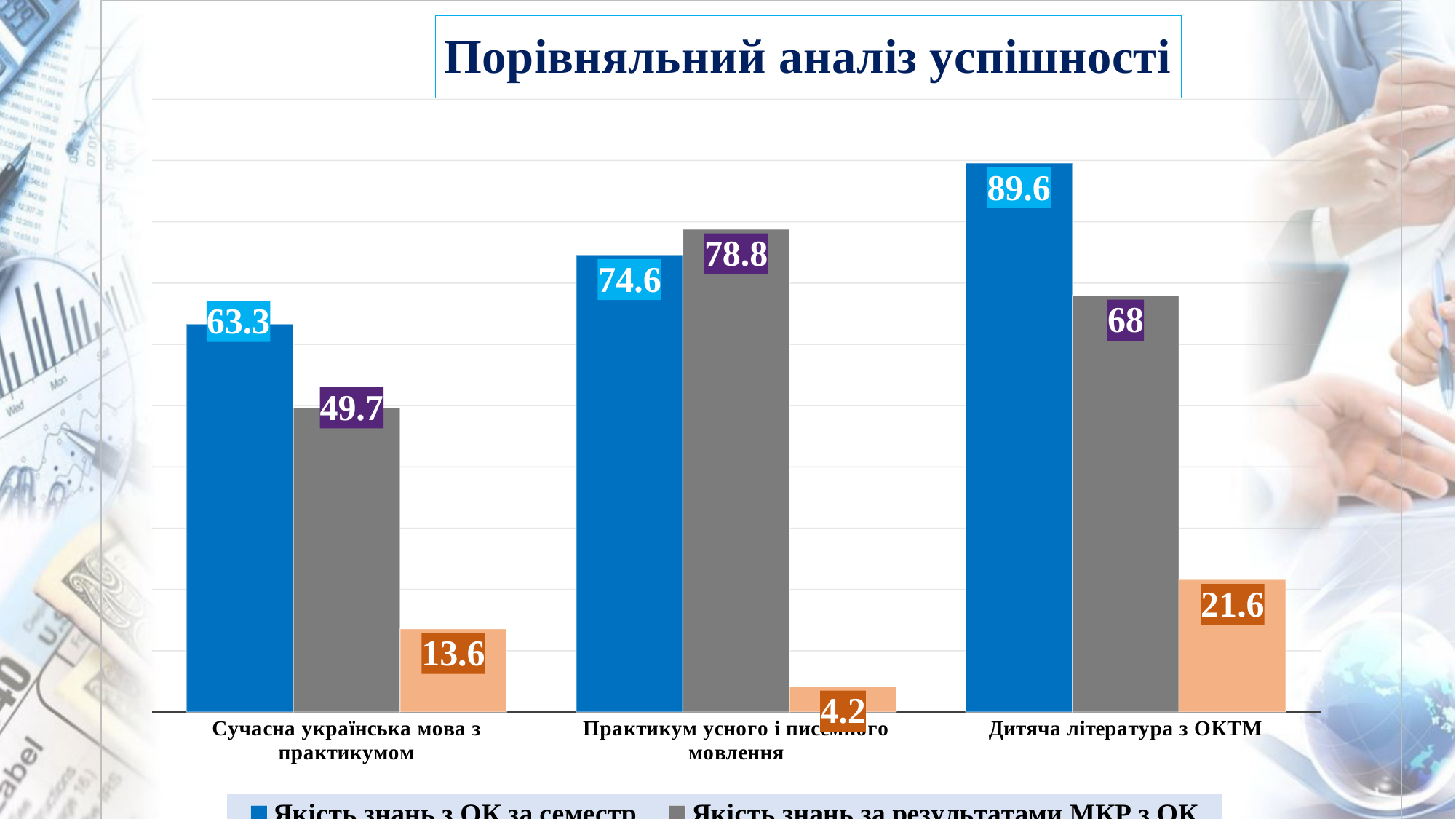
Which category has the highest value for 'Якість знань з ОК за семестр'? Дитяча література з ОКТМ What is the value of the orange bar for 'Практикум усного і писемного мовлення'? 4.2 What is the value of 'Якість знань з ОК за семестр' for 'Дитяча література з ОКТМ'? 89.6 Which colour is used for the 'Якість знань за результатами МКР з ОК' series? gray How many categories are shown along the x axis? 3 What type of chart is shown on the slide? bar chart What is the value of 'Якість знань за результатами МКР з ОК' for 'Сучасна українська мова з практикумом'? 49.7 What is the title of the chart? Порівняльний аналіз успішності For 'Практикум усного і писемного мовлення', which is larger: 'Якість знань з ОК за семестр' or 'Якість знань за результатами МКР з ОК'? Якість знань за результатами МКР з ОК What is the difference between 'Якість знань з ОК за семестр' and 'Якість знань за результатами МКР з ОК' for 'Дитяча література з ОКТМ'? 21.6 Which category has the lowest value for the orange series? Практикум усного і писемного мовлення What is the difference between the orange bar values for 'Дитяча література з ОКТМ' and 'Сучасна українська мова з практикумом'? 8